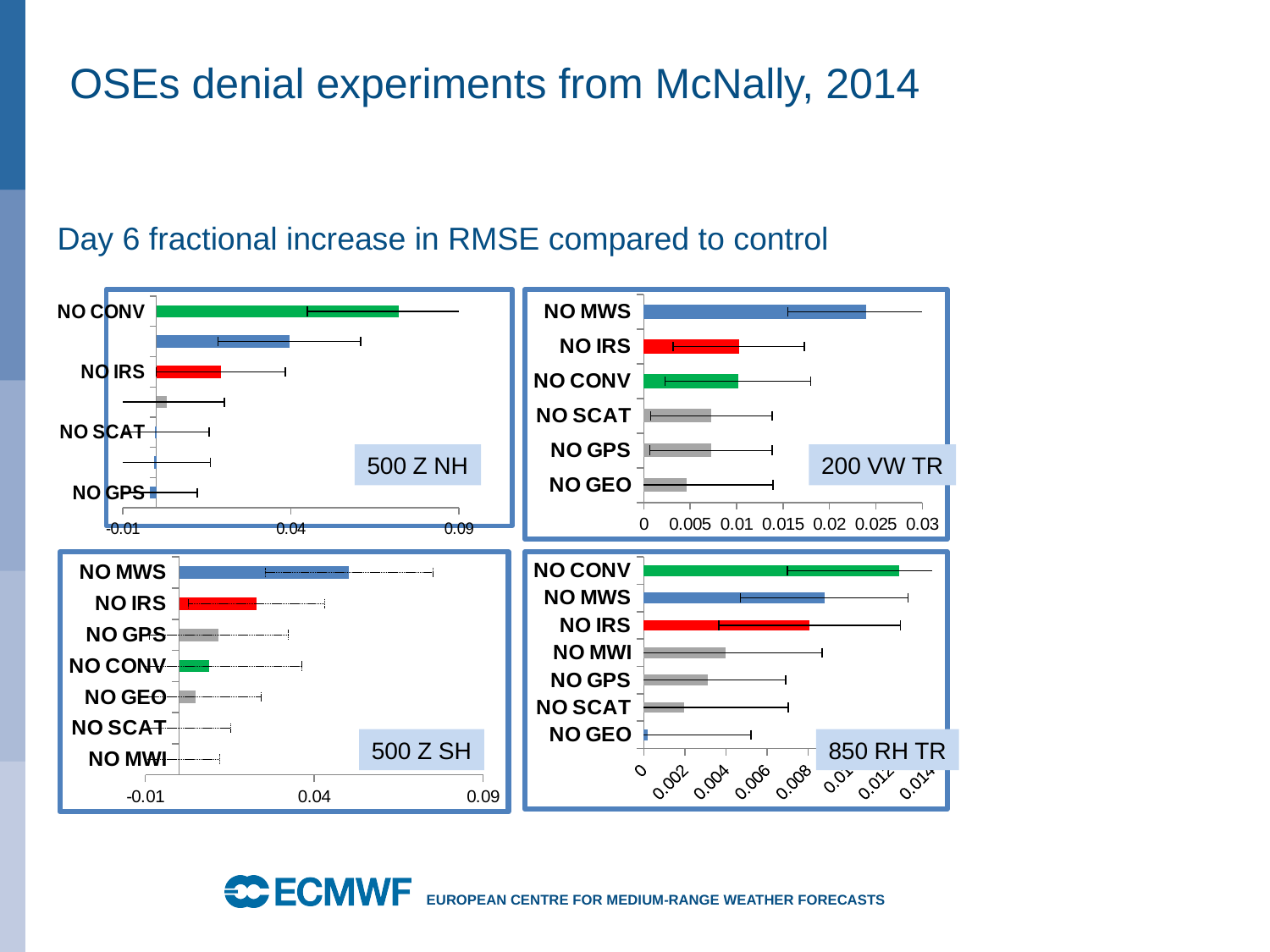
In the 500 Z NH chart, which category has the highest value? NO CONV In the 200 VW TR chart, is the value for NO MWS greater or less than 0.02? greater In the 500 Z NH chart, is the value for NO IRS greater or less than 0.04? less What kind of chart is the 850 RH TR chart? Bar chart In the 500 Z SH chart, which category has the highest value? NO MWS In the 200 VW TR chart, which category has the lowest value? NO GEO In the 850 RH TR chart, how many categories are shown? 7 In the 500 Z SH chart, which is larger, the value for NO IRS or the value for NO GPS? NO IRS In the 850 RH TR chart, which category has the highest value? NO CONV In the 500 Z SH chart, is the value for NO MWS greater or less than 0.04? greater In the 200 VW TR chart, how many categories are shown? 6